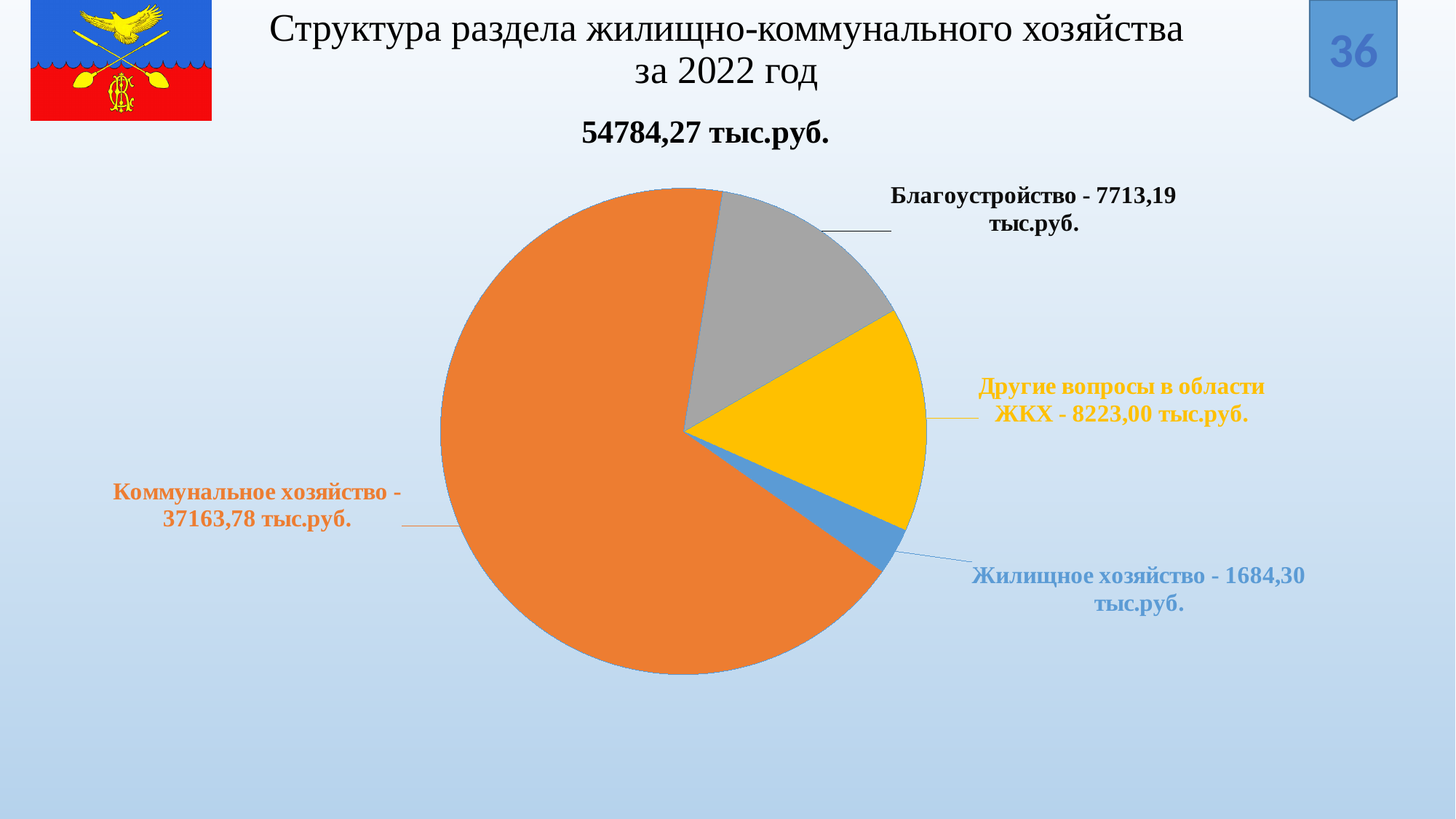
What total amount is shown above the pie chart? 54784,27 тыс.руб. Which is larger: Другие вопросы в области ЖКХ or Благоустройство? Другие вопросы в области ЖКХ What is the value for Благоустройство? 7713,19 тыс.руб. What colour is the slice for Жилищное хозяйство? blue What is the value for Жилищное хозяйство? 1684,30 тыс.руб. Which category has the largest slice of the pie? Коммунальное хозяйство What kind of chart is shown on the slide? pie chart Which category has the smallest slice of the pie? Жилищное хозяйство What is the value for Другие вопросы в области ЖКХ? 8223,00 тыс.руб. What is the difference between Другие вопросы в области ЖКХ and Благоустройство? 509,81 тыс.руб. How many slices does the pie chart have? 4 What is the value for Коммунальное хозяйство? 37163,78 тыс.руб.